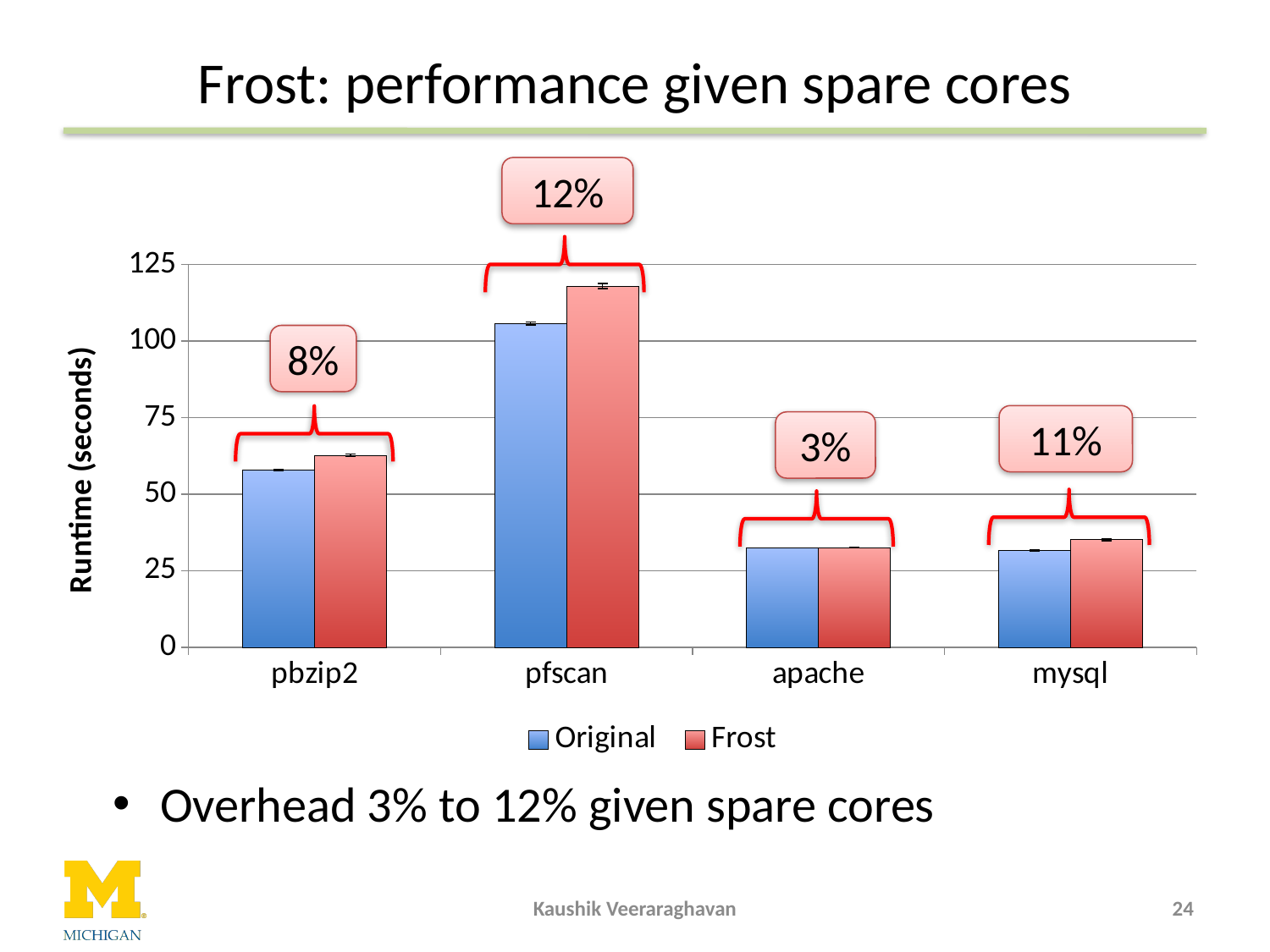
What kind of chart is shown on the slide? bar chart How many categories are shown on the x axis? 4 Is the Original runtime for apache greater or less than 25? greater How many series does the legend list? 2 Is the Frost runtime for pfscan greater or less than 125? less Which category has the highest runtime? pfscan Is the Frost runtime for mysql greater or less than 50? less Which is larger, the Frost runtime for pfscan or the Frost runtime for pbzip2? pfscan What is the label of the y axis? Runtime (seconds) What overhead percentage is annotated above the pfscan bars? 12%